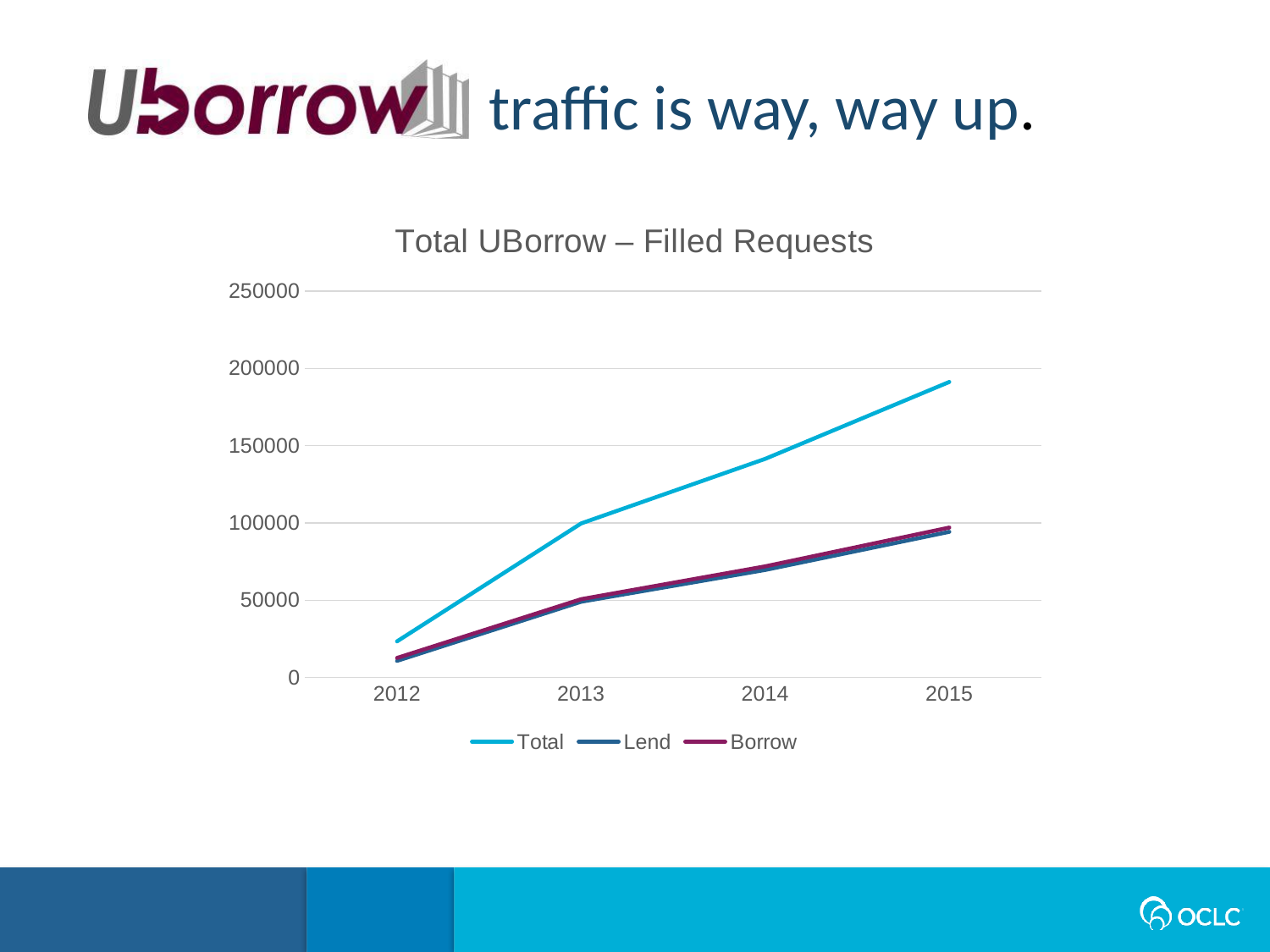
How many series does the legend list? 3 What kind of chart is shown on the slide? line chart Is the value for Total in 2014 greater or less than 100000? greater In which year is the Total series highest? 2015 Is the value for Total in 2015 greater or less than 150000? greater In which year is the Total series lowest? 2012 How many years are shown on the x axis? 4 Is the value for Total in 2012 greater or less than 50000? less Does the Total series rise or fall from 2012 to 2015? rise In 2015, which is larger, Total or Lend? Total What is the title of the chart? Total UBorrow – Filled Requests